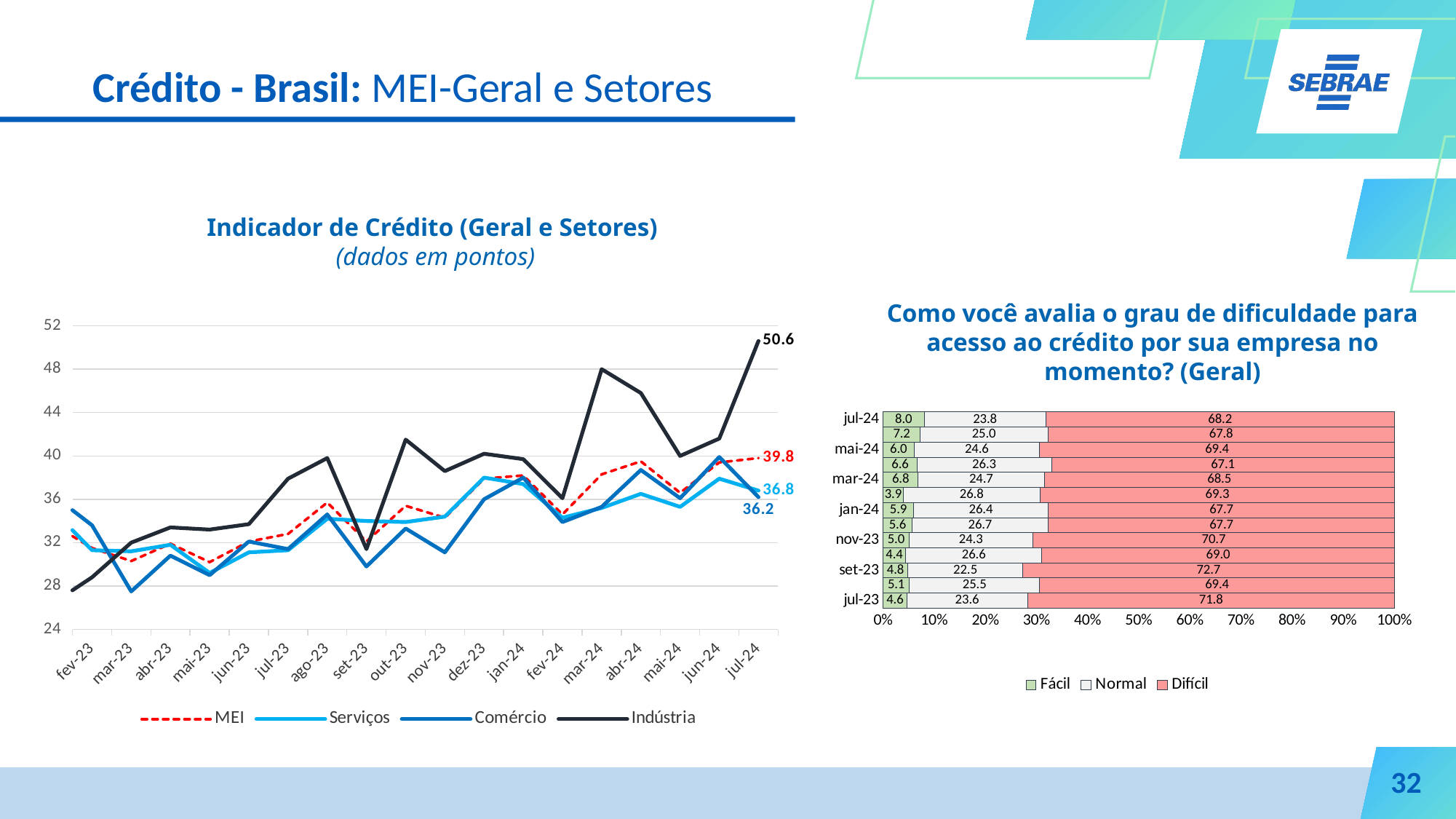
In the stacked bar chart on the right, is the Difícil value larger for nov-23 or for mar-24? nov-23 How many series does the legend of the line chart 'Indicador de Crédito (Geral e Setores)' list? 4 In the line chart 'Indicador de Crédito (Geral e Setores)', which series has the lowest value in jul-24? Comércio In the stacked bar chart on the right, what is the Fácil value for jul-23? 4.6 In the line chart 'Indicador de Crédito (Geral e Setores)', what is the difference between the Indústria and Comércio values in jul-24? 14.4 What kind of chart is 'Como você avalia o grau de dificuldade para acesso ao crédito por sua empresa no momento? (Geral)'? Stacked bar chart In the line chart 'Indicador de Crédito (Geral e Setores)', what is the value for MEI in jul-24? 39.8 In the line chart 'Indicador de Crédito (Geral e Setores)', is the value for Indústria in mar-24 greater or less than 44? greater How many months are shown on the x axis of the line chart 'Indicador de Crédito (Geral e Setores)'? 18 In the stacked bar chart on the right, what is the Difícil value for jul-24? 68.2 In the line chart 'Indicador de Crédito (Geral e Setores)', what is the value for Indústria in jul-24? 50.6 In the stacked bar chart on the right, which month has the highest Difícil value? set-23